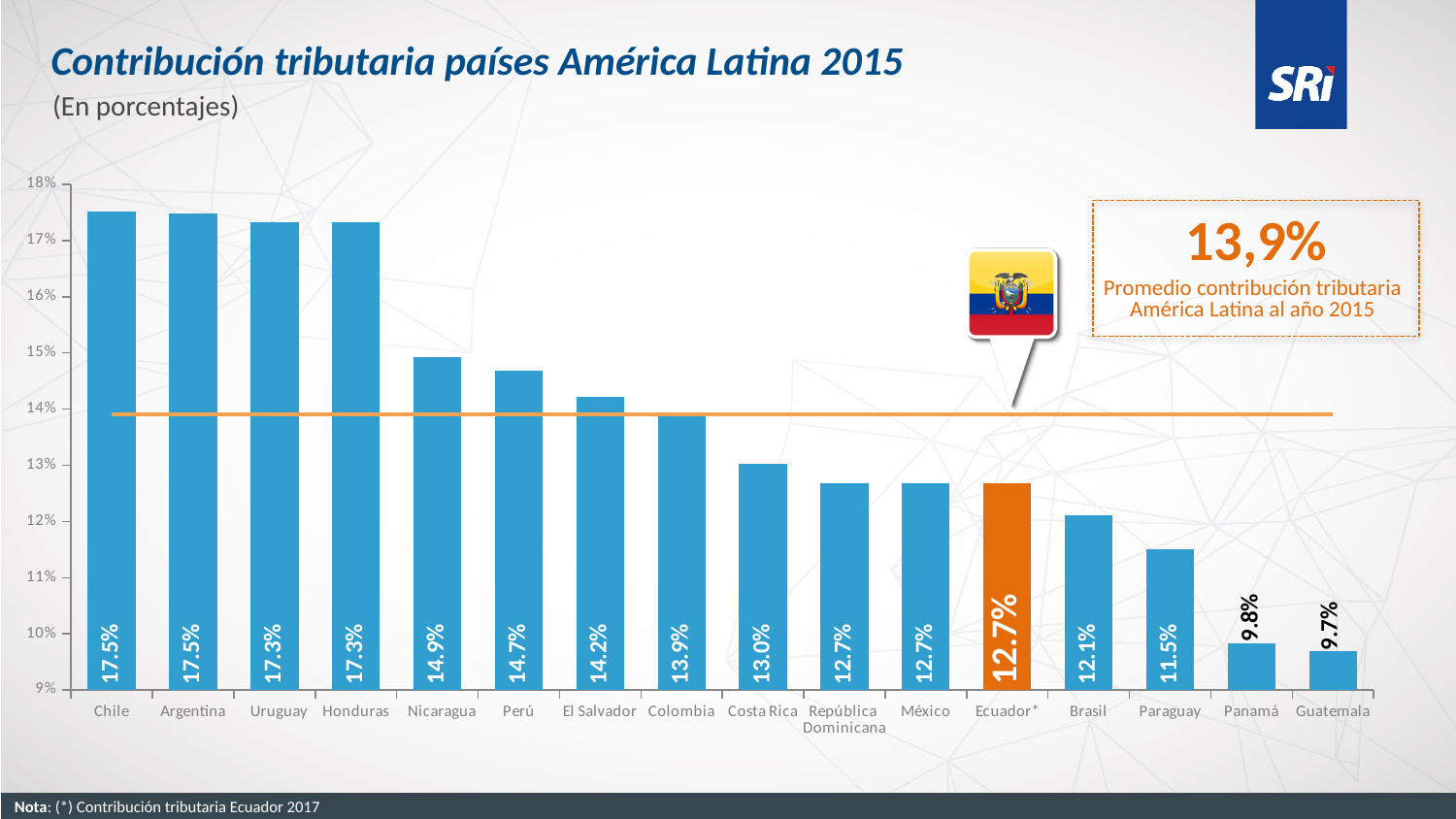
Do the values rise or fall from left to right along the x axis? Fall What is the difference between the values for Perú and Brasil? 2.6% What is the value for Paraguay? 11.5% Which countries share the highest value? Chile and Argentina How many countries are shown on the x axis? 16 What kind of chart is shown? Bar chart What average value is shown in the orange box for América Latina in 2015? 13,9% What is the value for Ecuador*? 12.7% What is the difference between the values for Chile and Guatemala? 7.8% Which country has the lowest value? Guatemala What is the value for Nicaragua? 14.9% Which is larger, the value for Costa Rica or the value for Colombia? Colombia